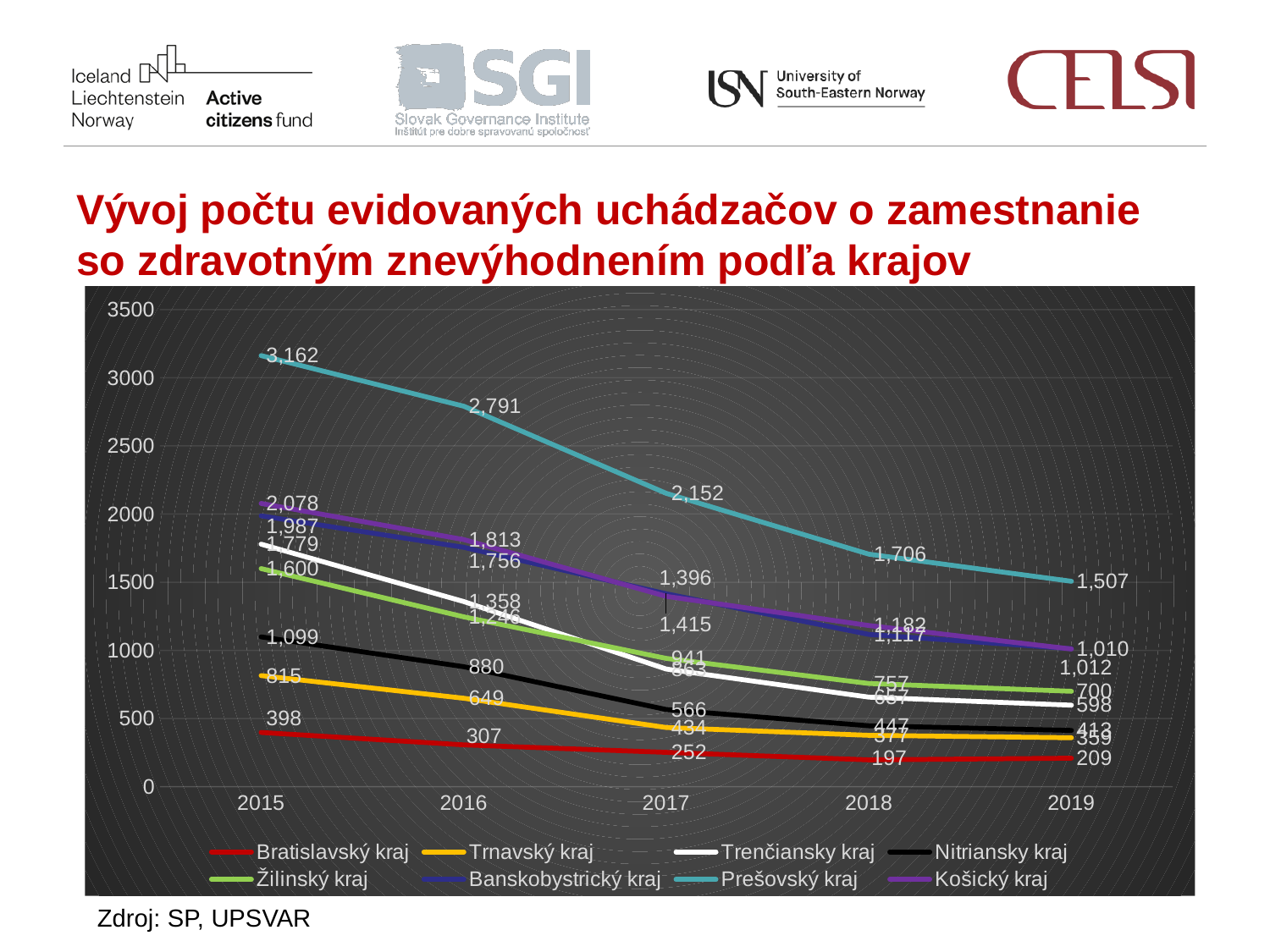
What is the value for Nitriansky kraj in 2016? 880 By how much did the value for Prešovský kraj fall from 2015 to 2019? 1,655 How many years are shown on the x axis? 5 For Bratislavský kraj, which year has the larger value, 2018 or 2019? 2019 Which region has the highest value in 2015? Prešovský kraj What is the value for Bratislavský kraj in 2015? 398 What is the value for Prešovský kraj in 2015? 3,162 Which region has the lowest value in 2019? Bratislavský kraj How many series (regions) does the legend list? 8 Does the value for Prešovský kraj rise or fall from 2015 to 2019? fall What is the value for Prešovský kraj in 2019? 1,507 What kind of chart is shown on the slide? line chart